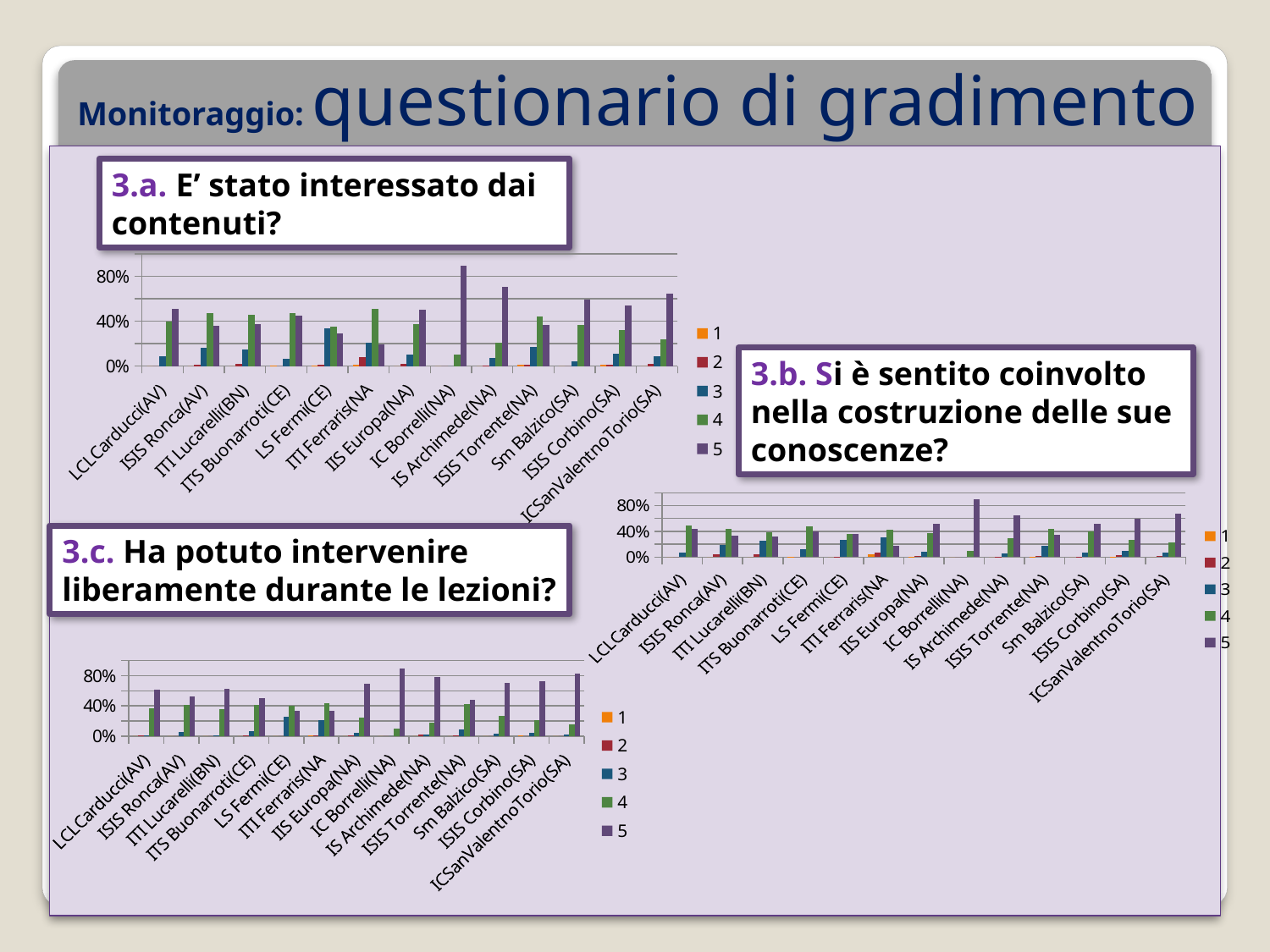
In the chart for 3.c 'Ha potuto intervenire liberamente durante le lezioni?', which school has the tallest bar for series 5? IC Borrelli(NA) In the chart for 3.c 'Ha potuto intervenire liberamente durante le lezioni?', is the value of series 5 for LCL Carducci(AV) greater or less than 40%? greater In the chart for 3.b 'Si è sentito coinvolto nella costruzione delle sue conoscenze?', is the value of series 5 for IC Borrelli(NA) greater or less than 80%? greater In the chart for 3.a 'E' stato interessato dai contenuti?', which school has the tallest bar for series 5? IC Borrelli(NA) In the chart for 3.a 'E' stato interessato dai contenuti?', for IC Borrelli(NA), which is larger: series 4 or series 5? series 5 What is the question text shown above the top-left chart (3.a)? E' stato interessato dai contenuti? In the chart for 3.a 'E' stato interessato dai contenuti?', is the value of series 3 for LCL Carducci(AV) greater or less than 40%? less In the chart for 3.c 'Ha potuto intervenire liberamente durante le lezioni?', for LCL Carducci(AV), which is larger: series 4 or series 5? series 5 How many schools (categories) are shown on the x axis of the chart for 3.b 'Si è sentito coinvolto nella costruzione delle sue conoscenze?'? 13 How many series does the legend of the chart for 3.c 'Ha potuto intervenire liberamente durante le lezioni?' list? 5 What kind of chart is used for question 3.a 'E' stato interessato dai contenuti?'? bar chart